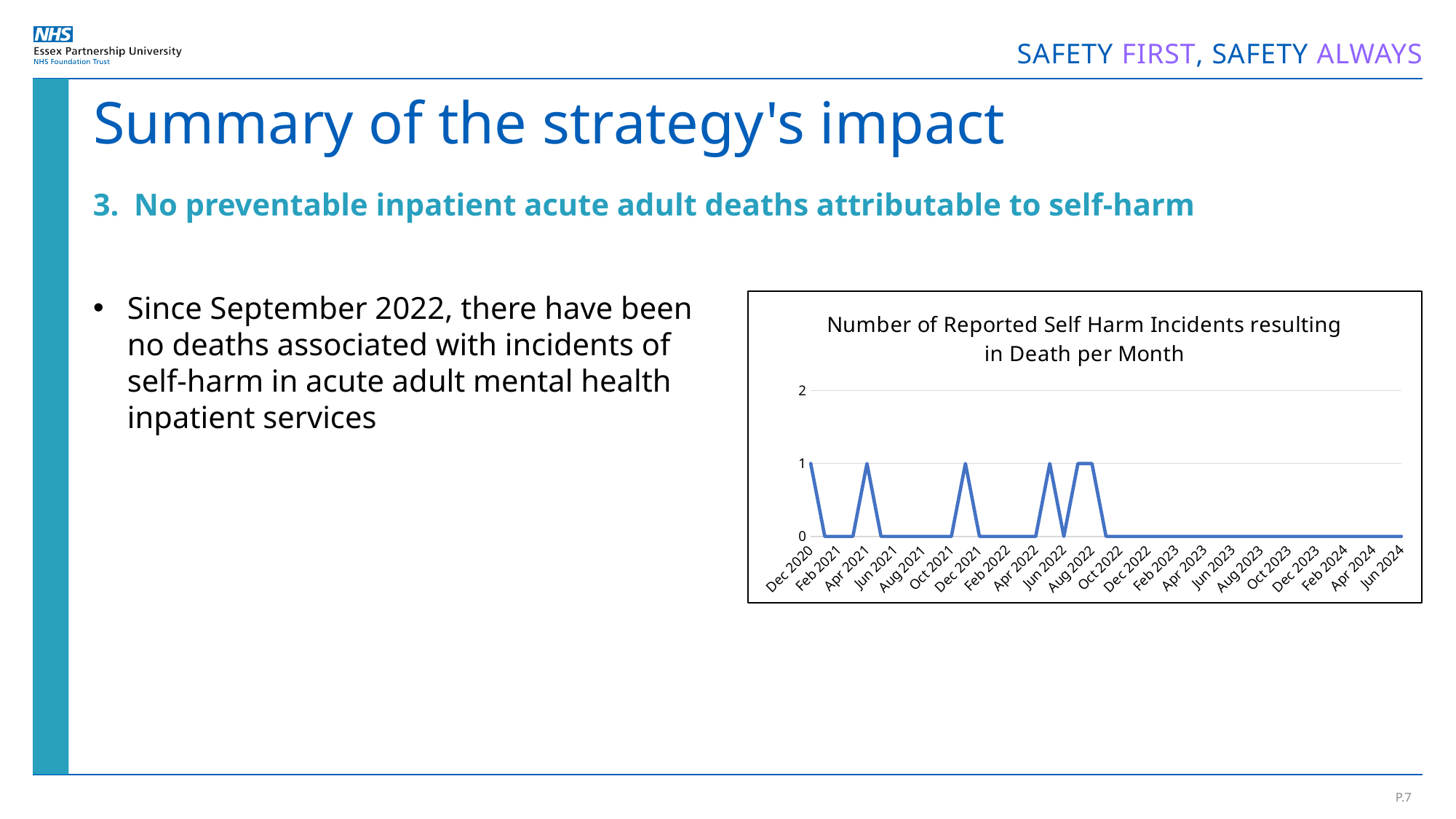
How many month labels are shown on the x axis? 22 What is the value for Apr 2021? 1 What is the value for Dec 2020? 1 What is the title of the chart? Number of Reported Self Harm Incidents resulting in Death per Month What is the value for Jun 2022? 0 Which is larger, the value for Dec 2020 or the value for Feb 2021? Dec 2020 What is the highest value reached by the line? 1 What is the value for Jun 2024? 0 What is the value for Feb 2023? 0 What kind of chart is shown on the slide? line chart What is the value for Dec 2021? 0 What is the difference between the value for Dec 2020 and the value for Aug 2021? 1